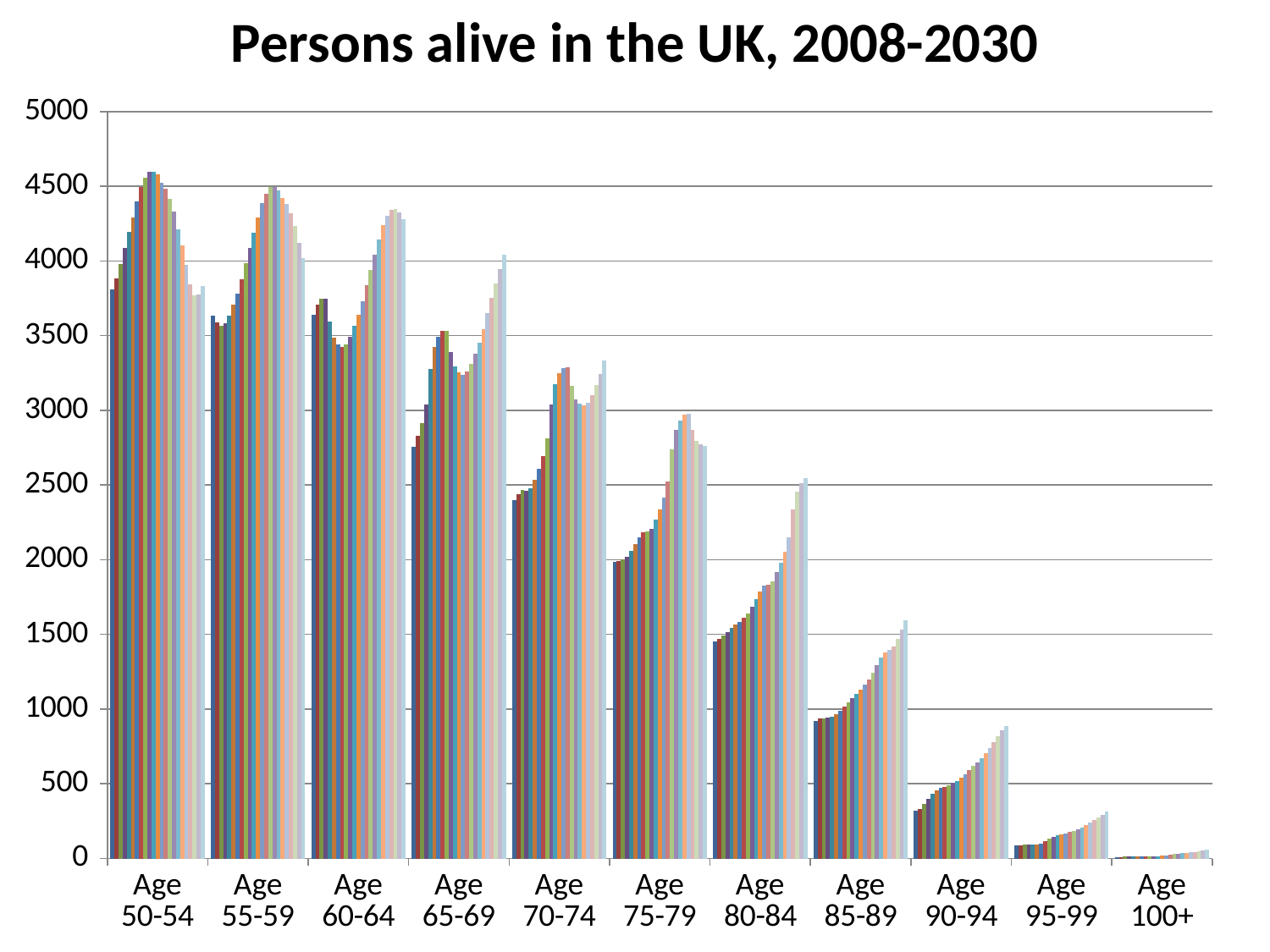
Which age group has the shortest bars on the chart? Age 100+ Are the values for Age 90-94 greater or less than 1000? less Which age group has larger values, Age 60-64 or Age 80-84? Age 60-64 Do the bar heights generally rise or fall moving from Age 50-54 to Age 100+ along the x axis? fall Are the values for Age 50-54 greater or less than 3500? greater What is the title of the chart? Persons alive in the UK, 2008-2030 What kind of chart is shown on the slide? bar chart Are the values for Age 100+ greater or less than 500? less Which age group has the tallest bars on the chart? Age 50-54 How many age-group categories are shown on the x axis? 11